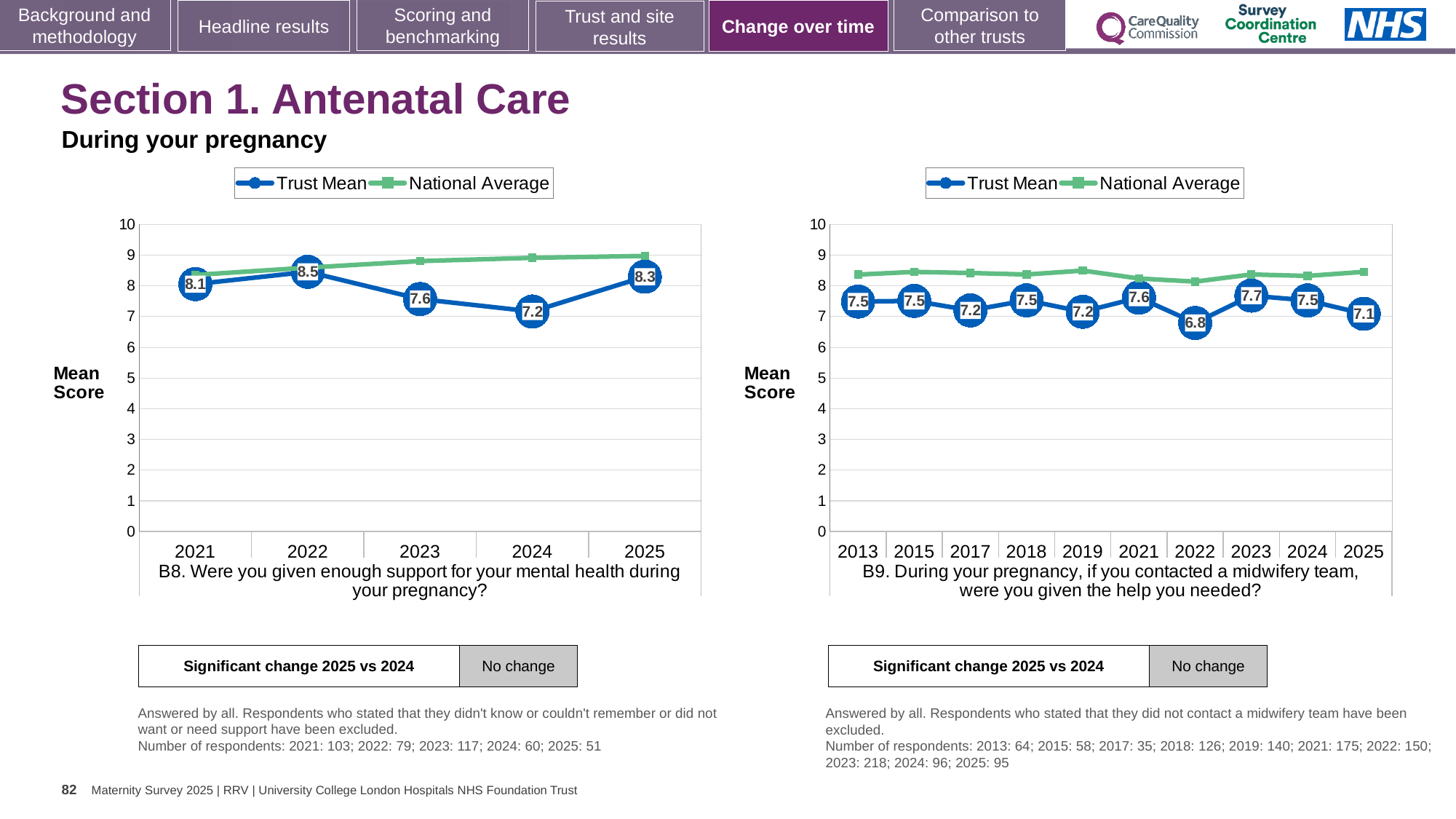
In the B9 chart (right), what is the difference between the Trust Mean in 2023 and in 2022? 0.9 In the B9 chart (right), what is the Trust Mean for 2022? 6.8 In the B9 chart (right), is the Trust Mean higher in 2021 or in 2025? 2021 In the B8 chart (left), is the National Average for 2025 greater or less than 8? greater In the B8 chart (left), what is the Trust Mean for 2022? 8.5 What kind of chart is the B8 chart (left)? Line chart In the B8 chart (left), what is the difference between the Trust Mean in 2022 and in 2024? 1.3 In the B8 chart (left), how many years are plotted on the x axis? 5 How many series does the legend of the B9 chart (right) list? 2 In the B9 chart (right), how many years are plotted on the x axis? 10 In the B9 chart (right), which year has the highest Trust Mean? 2023 In the B8 chart (left), which year has the lowest Trust Mean? 2024